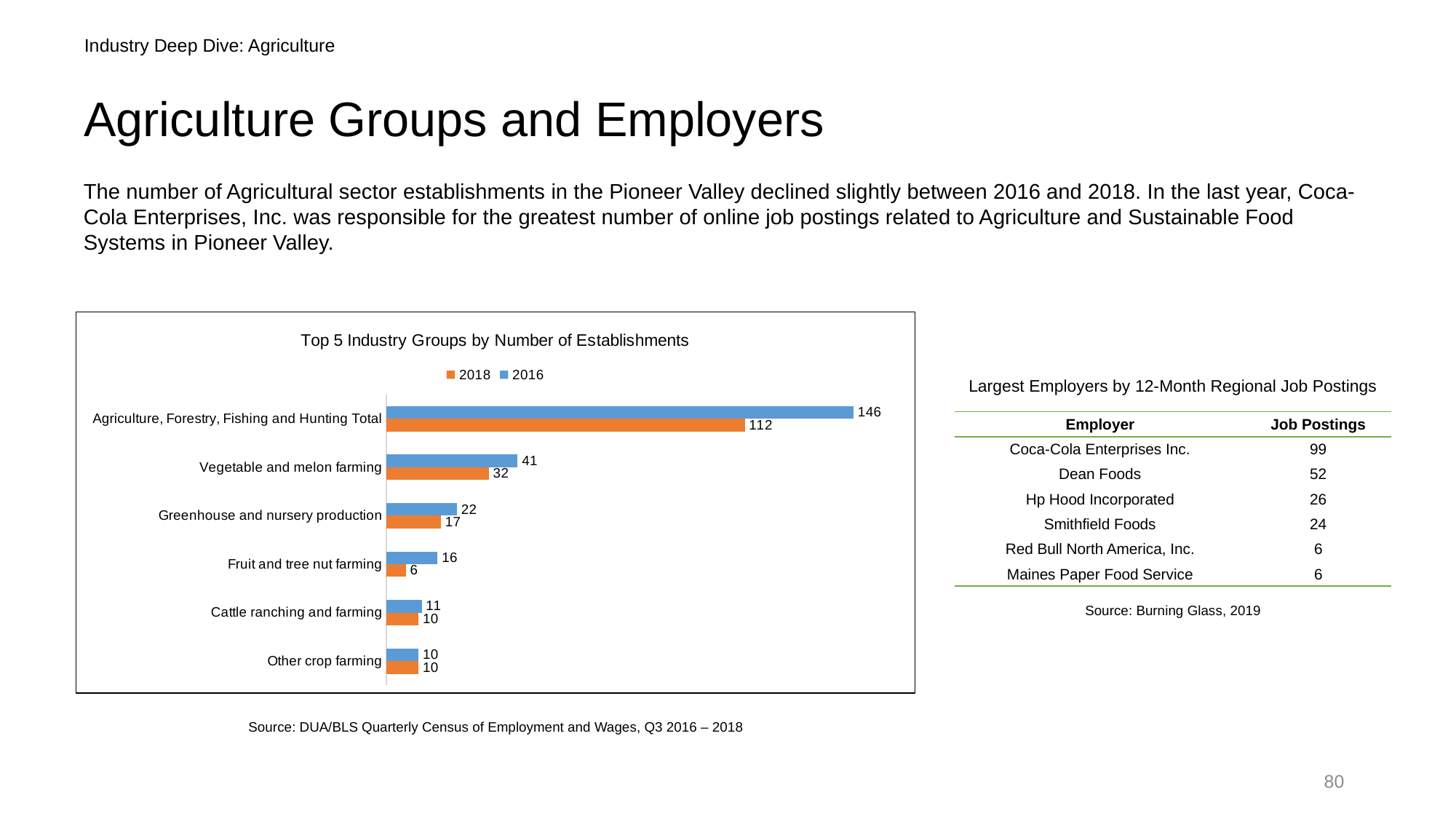
What was the 2016 value for Agriculture, Forestry, Fishing and Hunting Total? 146 How many series does the chart legend list? 2 What was the 2018 value for Fruit and tree nut farming? 6 Which colour represents the 2018 series in the chart? Orange What type of chart is shown on the slide? Bar chart How many categories are plotted in the chart? 6 What is the difference between the 2016 and 2018 values for Agriculture, Forestry, Fishing and Hunting Total? 34 Which is larger for Greenhouse and nursery production: the 2016 value or the 2018 value? 2016 Which category has the lowest 2016 value? Other crop farming What was the 2018 value for Vegetable and melon farming? 32 Which category has the highest 2018 value? Agriculture, Forestry, Fishing and Hunting Total What is the title of the chart? Top 5 Industry Groups by Number of Establishments